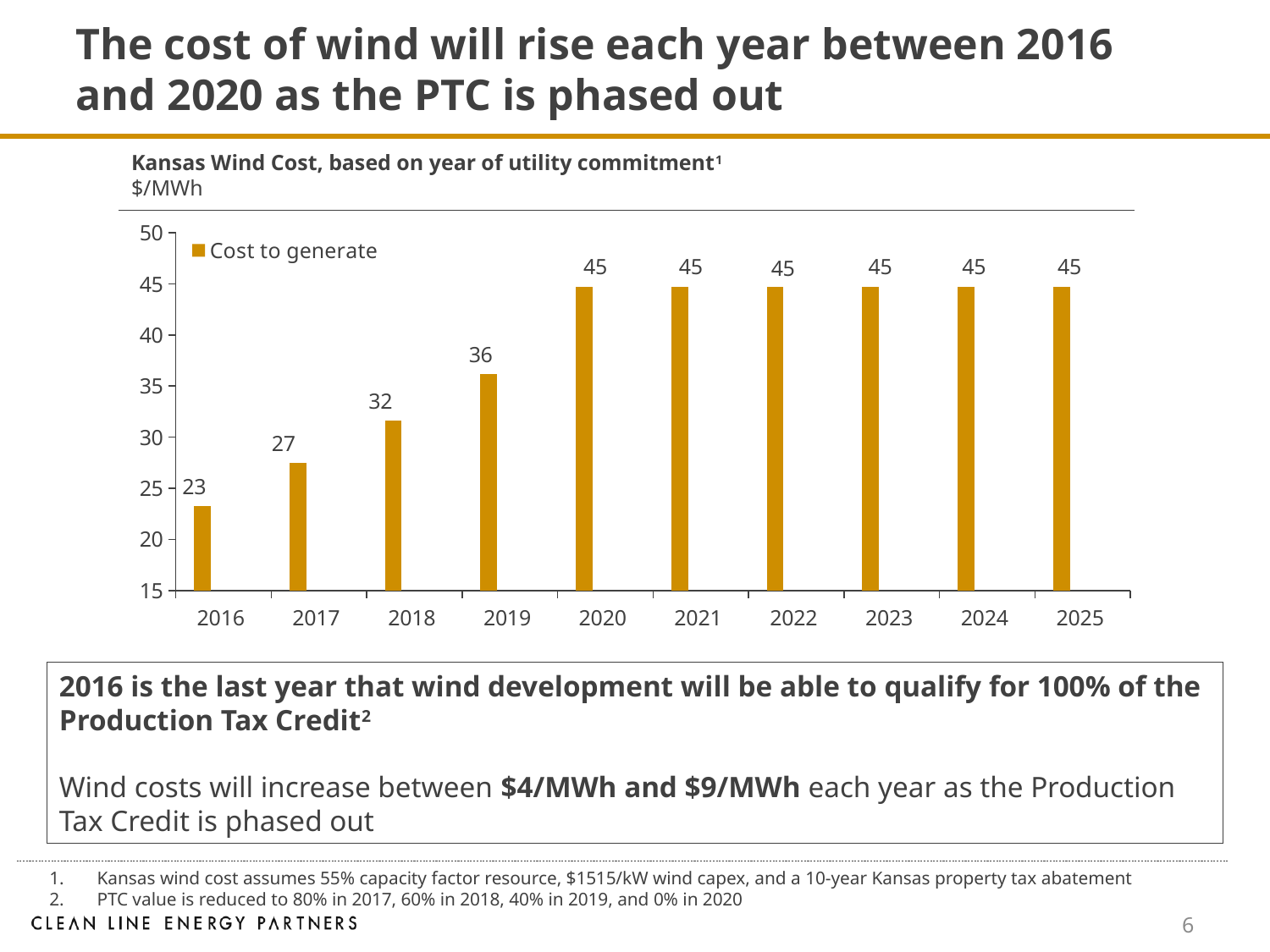
What is the cost to generate for 2019? 36 What is the cost to generate for 2016? 23 What is the difference between the cost to generate in 2017 and in 2016? 4 What kind of chart is shown on the slide? bar chart How many series does the legend list? 1 What is the cost to generate for 2018? 32 Which year has the lowest cost to generate? 2016 Is the value for 2017 greater or less than 30? less How many years are shown on the x axis? 10 Do the values rise or fall from 2016 to 2020? rise What is the difference between the cost to generate in 2020 and in 2016? 22 Which is larger, the cost to generate in 2019 or in 2018? 2019